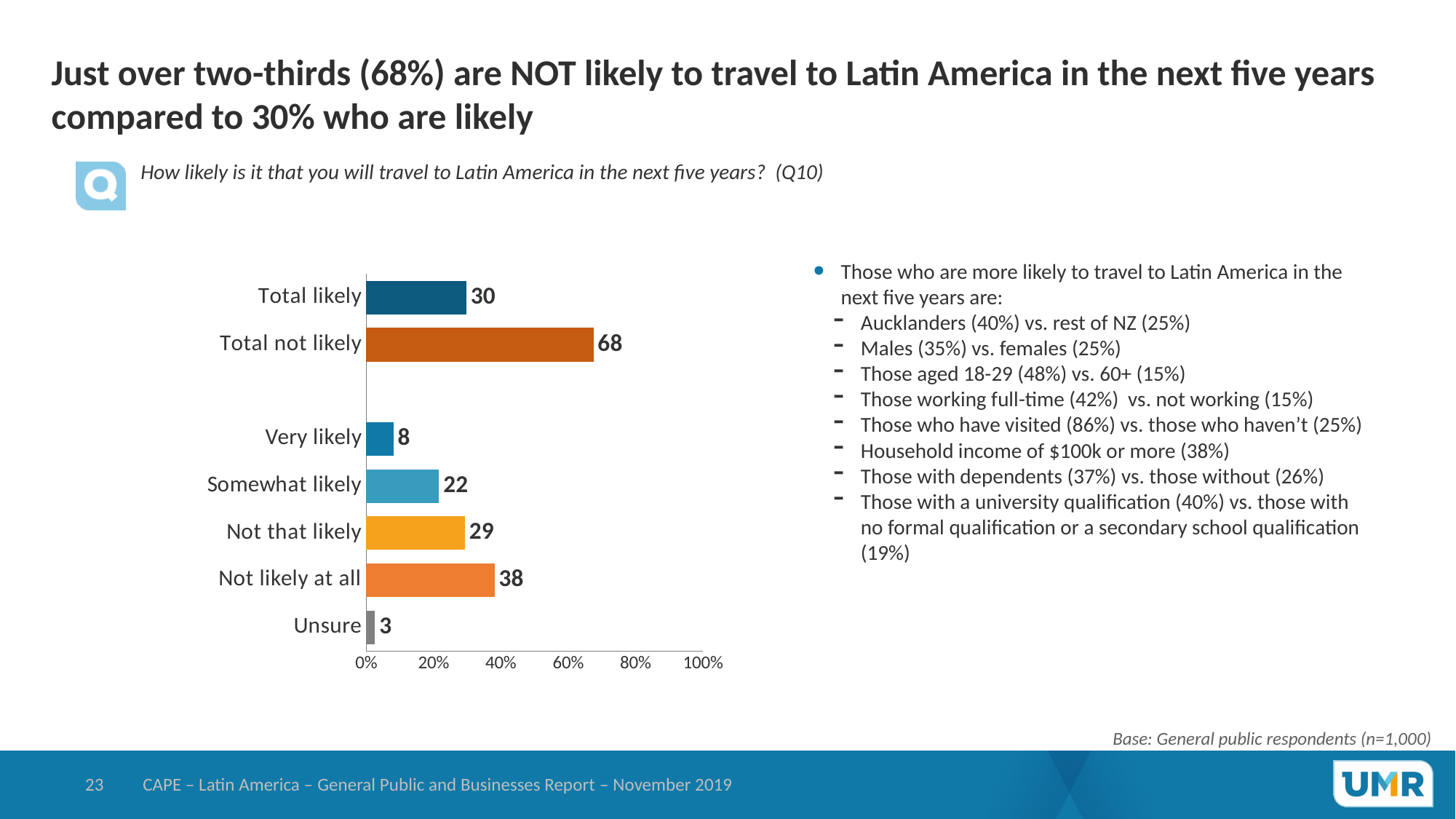
What is the difference between Total not likely and Total likely? 38 Which is larger, Very likely or Somewhat likely? Somewhat likely What is the value for Total not likely? 68 What is the difference between Not likely at all and Not that likely? 9 Which category has the lowest value? Unsure Which category has the highest value? Total not likely What kind of chart is shown on the slide? Bar chart What is the value for Not likely at all? 38 Is the value for Not likely at all greater or less than 20%? greater What is the value for Unsure? 3 What is the value for Somewhat likely? 22 How many categories are shown in the chart? 7